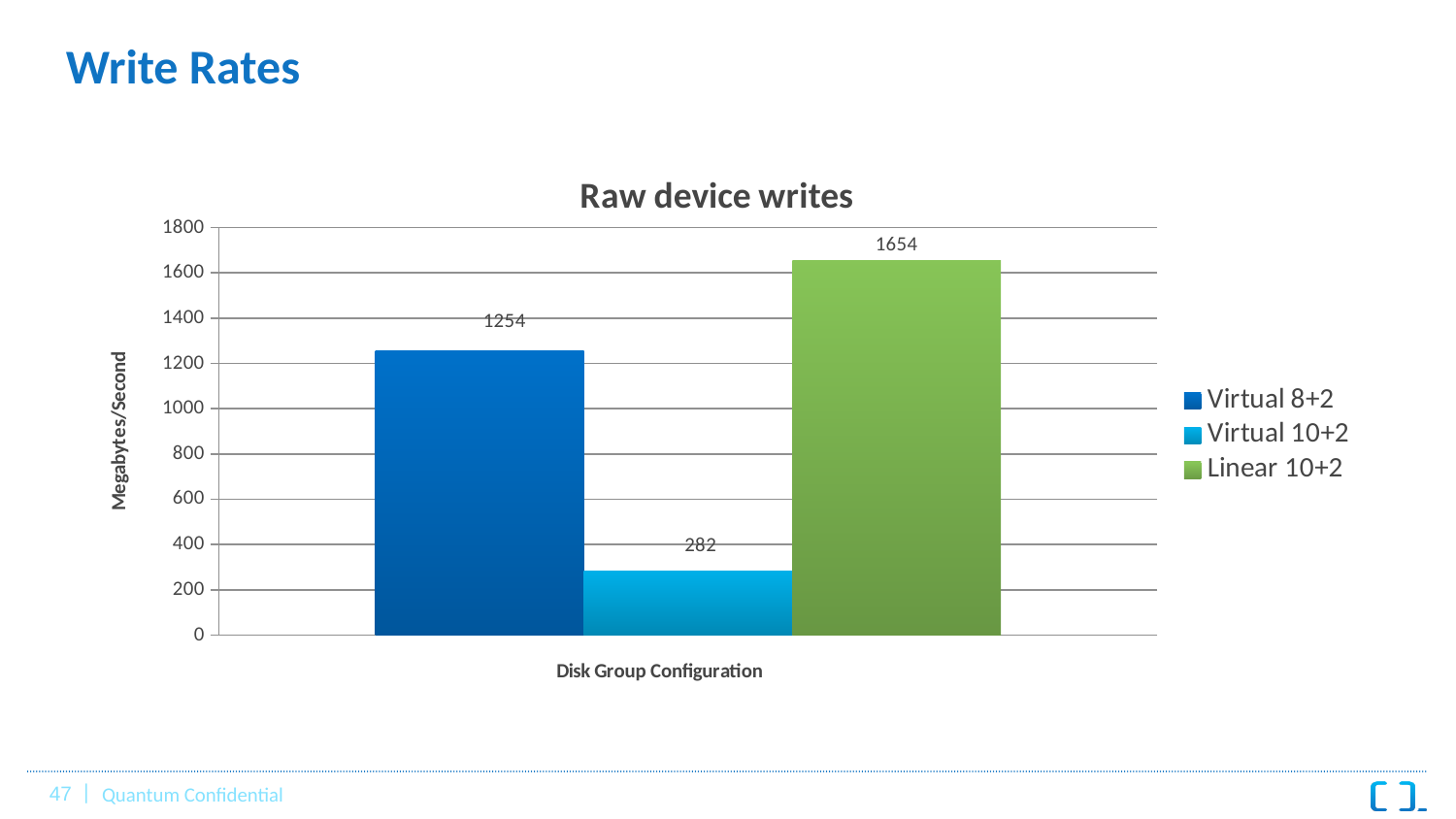
Is the value for Linear 10+2 greater or less than 1600? greater What kind of chart is shown? bar chart What is the title of the chart? Raw device writes Which is larger, Virtual 8+2 or Virtual 10+2? Virtual 8+2 What is the value for Virtual 10+2? 282 What is the value for Virtual 8+2? 1254 Which series has the highest value? Linear 10+2 What is the difference between the Linear 10+2 and Virtual 8+2 values? 400 What is the difference between the Virtual 8+2 and Virtual 10+2 values? 972 What is the value for Linear 10+2? 1654 How many series does the legend list? 3 Which series has the lowest value? Virtual 10+2